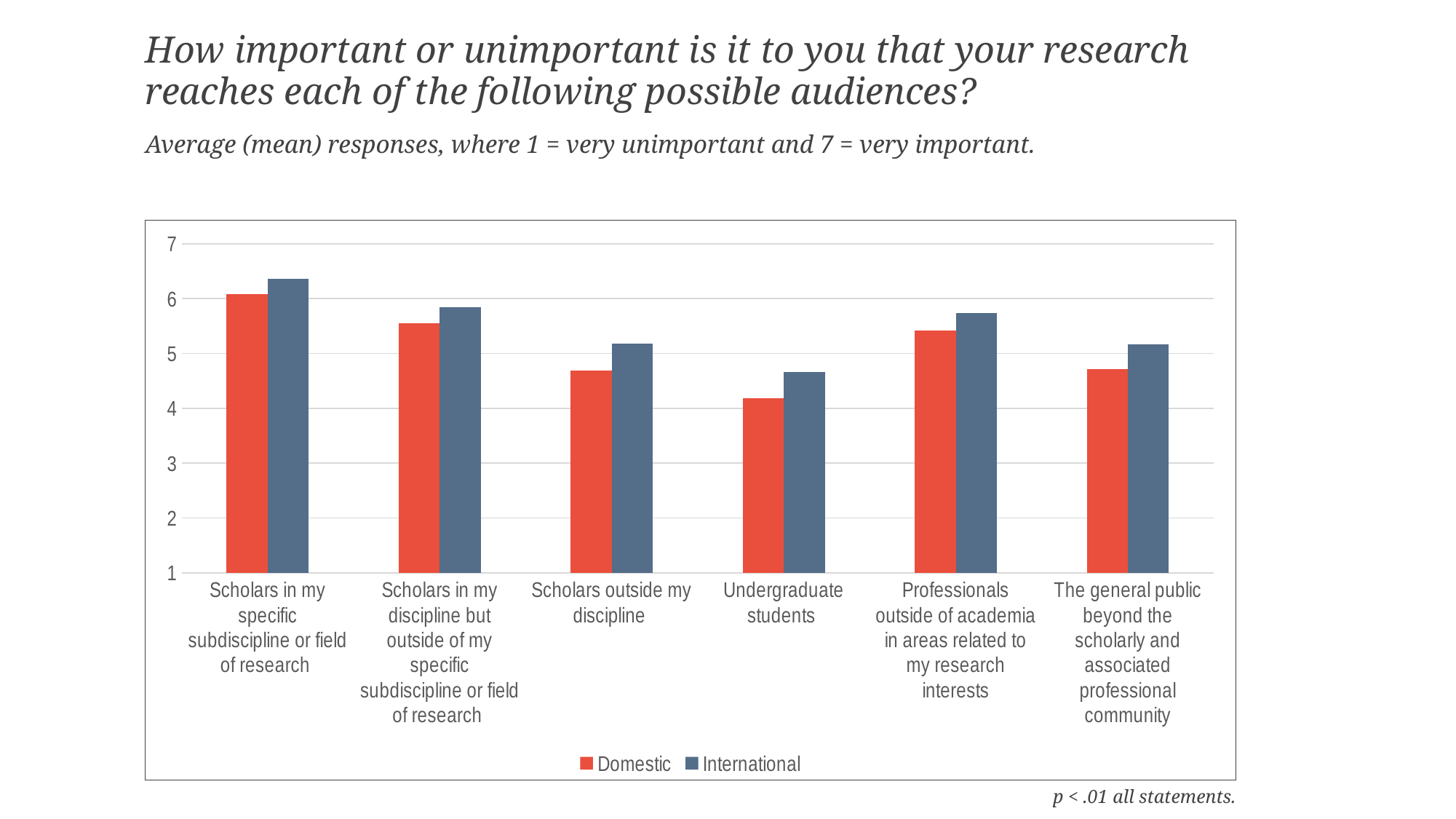
How many audience categories are shown on the x axis? 6 Which audience has the highest Domestic value? Scholars in my specific subdiscipline or field of research Which audience has the lowest Domestic value? Undergraduate students Is the International value for Scholars in my specific subdiscipline or field of research greater or less than 6? greater Is the Domestic value for Scholars outside my discipline greater or less than 5? less How many series does the legend list? 2 For Undergraduate students, which is larger: the Domestic or the International value? International Which audience has the lowest International value? Undergraduate students What kind of chart is shown on the slide? bar chart Which series is shown in red in the legend? Domestic Is the International value for Professionals outside of academia in areas related to my research interests greater or less than 5? greater